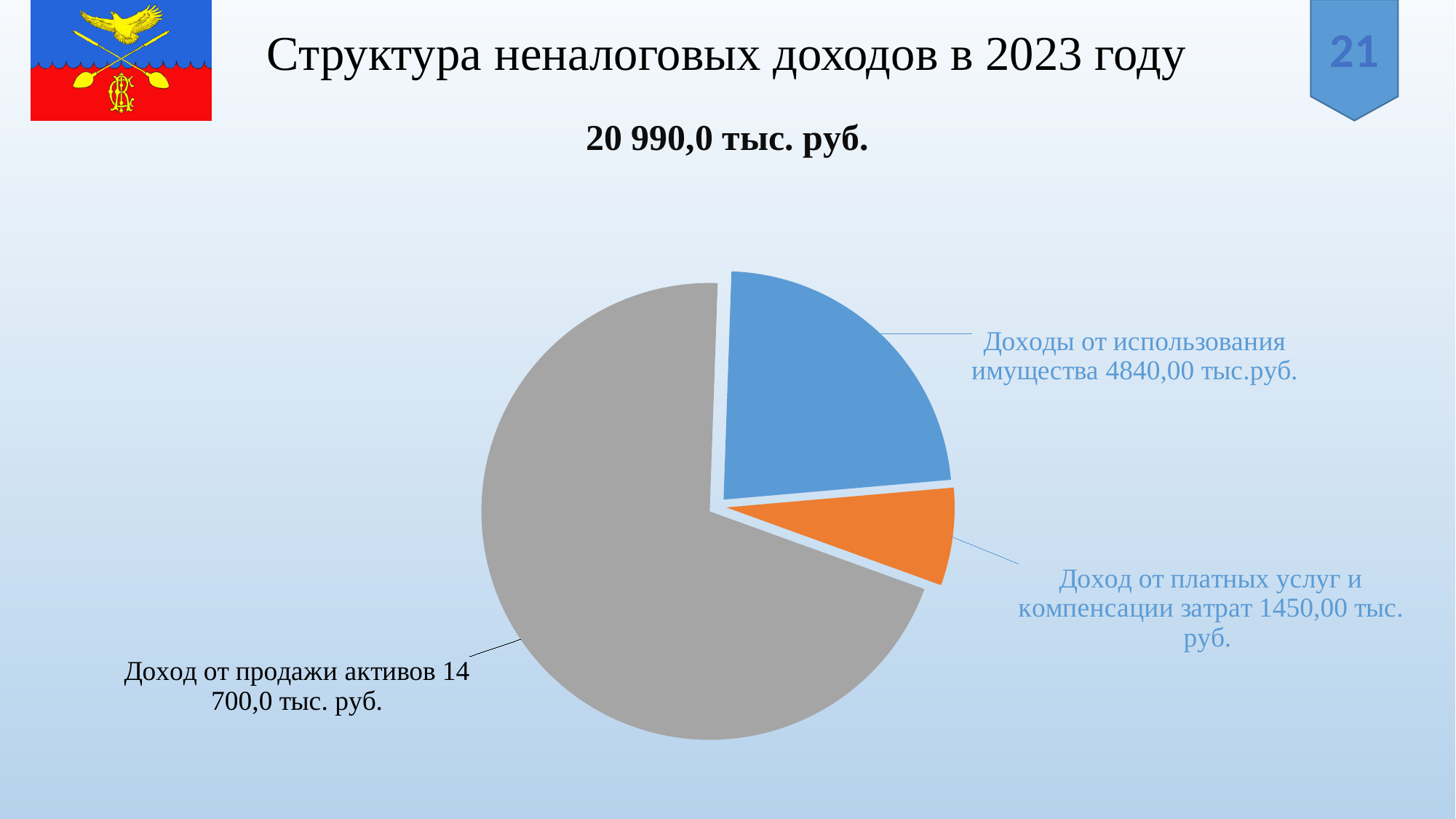
Which category has the smallest slice of the pie? Доход от платных услуг и компенсации затрат How many slices does the pie chart have? 3 What colour is the slice for «Доход от продажи активов»? Gray What is the difference between «Доходы от использования имущества» and «Доход от платных услуг и компенсации затрат»? 3 390,0 тыс. руб. What is the value for «Доход от продажи активов»? 14 700,0 тыс. руб. Which is larger: «Доходы от использования имущества» or «Доход от платных услуг и компенсации затрат»? Доходы от использования имущества What total amount of non-tax revenue is stated above the pie chart? 20 990,0 тыс. руб. What is the difference between «Доход от продажи активов» and «Доходы от использования имущества»? 9 860,0 тыс. руб. What is the value for «Доход от платных услуг и компенсации затрат»? 1450,00 тыс. руб. Which category has the largest slice of the pie? Доход от продажи активов What is the value for «Доходы от использования имущества»? 4840,00 тыс.руб. What kind of chart is shown on the slide? Pie chart